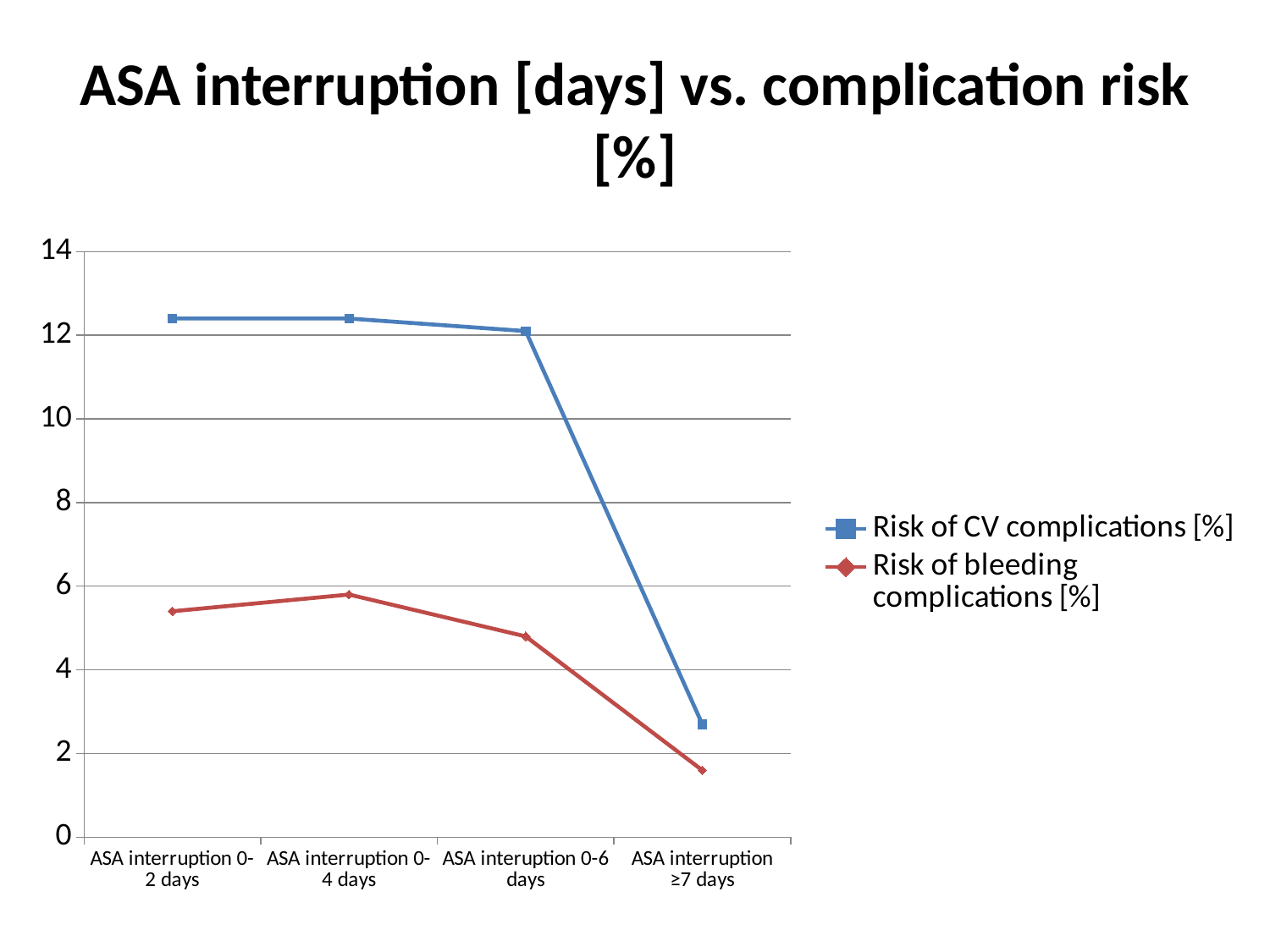
Does the Risk of CV complications [%] series rise or fall from ASA interruption 0-6 days to ASA interruption ≥7 days? fall How many series does the legend list? 2 Which category has the lowest value for Risk of CV complications [%]? ASA interruption ≥7 days Is the value for Risk of bleeding complications [%] at ASA interruption 0-2 days greater or less than 4? greater Is the value for Risk of CV complications [%] at ASA interruption ≥7 days greater or less than 4? less Which category has the lowest value for Risk of bleeding complications [%]? ASA interruption ≥7 days How many categories are shown on the x axis? 4 What is the title of the chart? ASA interruption [days] vs. complication risk [%] What kind of chart is shown on the slide? line chart Is the value for Risk of CV complications [%] at ASA interruption 0-2 days greater or less than 10? greater At ASA interruption 0-6 days, which series has the larger value: Risk of CV complications [%] or Risk of bleeding complications [%]? Risk of CV complications [%]